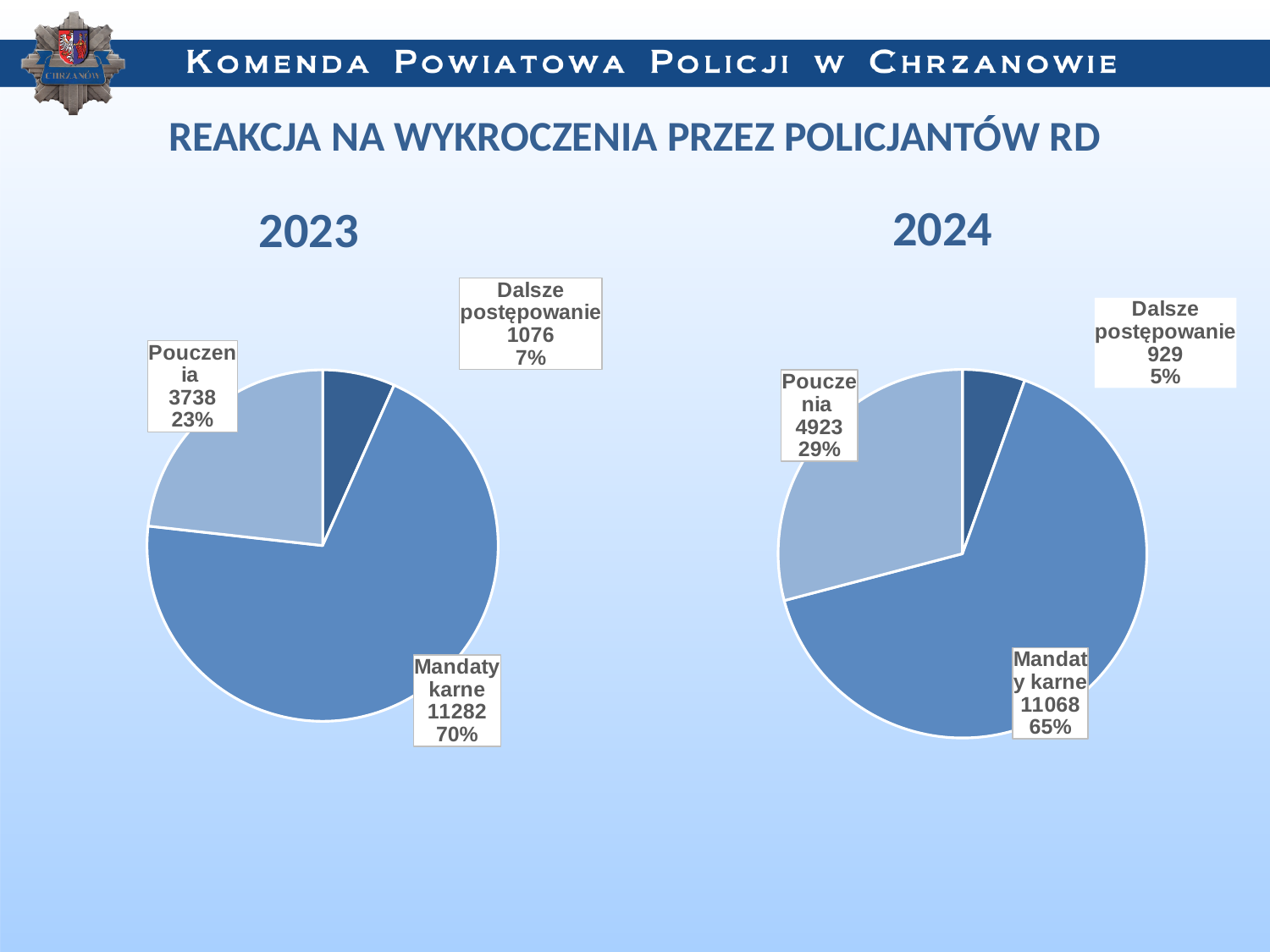
In the 2023 pie chart, what share of the pie does Pouczenia have? 23% Which is larger: Pouczenia in the 2023 chart or Pouczenia in the 2024 chart? Pouczenia in the 2024 chart In the 2024 pie chart, what share of the pie does Dalsze postępowanie have? 5% In the 2023 pie chart, what is the value for Dalsze postępowanie? 1076 In the 2024 pie chart, what is the value for Pouczenia? 4923 In the 2023 pie chart, what is the value for Mandaty karne? 11282 What is the difference between the Mandaty karne value in the 2023 chart and the Mandaty karne value in the 2024 chart? 214 In the 2024 pie chart, which category has the largest slice? Mandaty karne In the 2024 pie chart, what is the difference between Pouczenia and Dalsze postępowanie? 3994 In the 2023 pie chart, which category has the smallest slice? Dalsze postępowanie What type of chart is used for the 2024 data? Pie chart How many slices does the 2023 pie chart have? 3